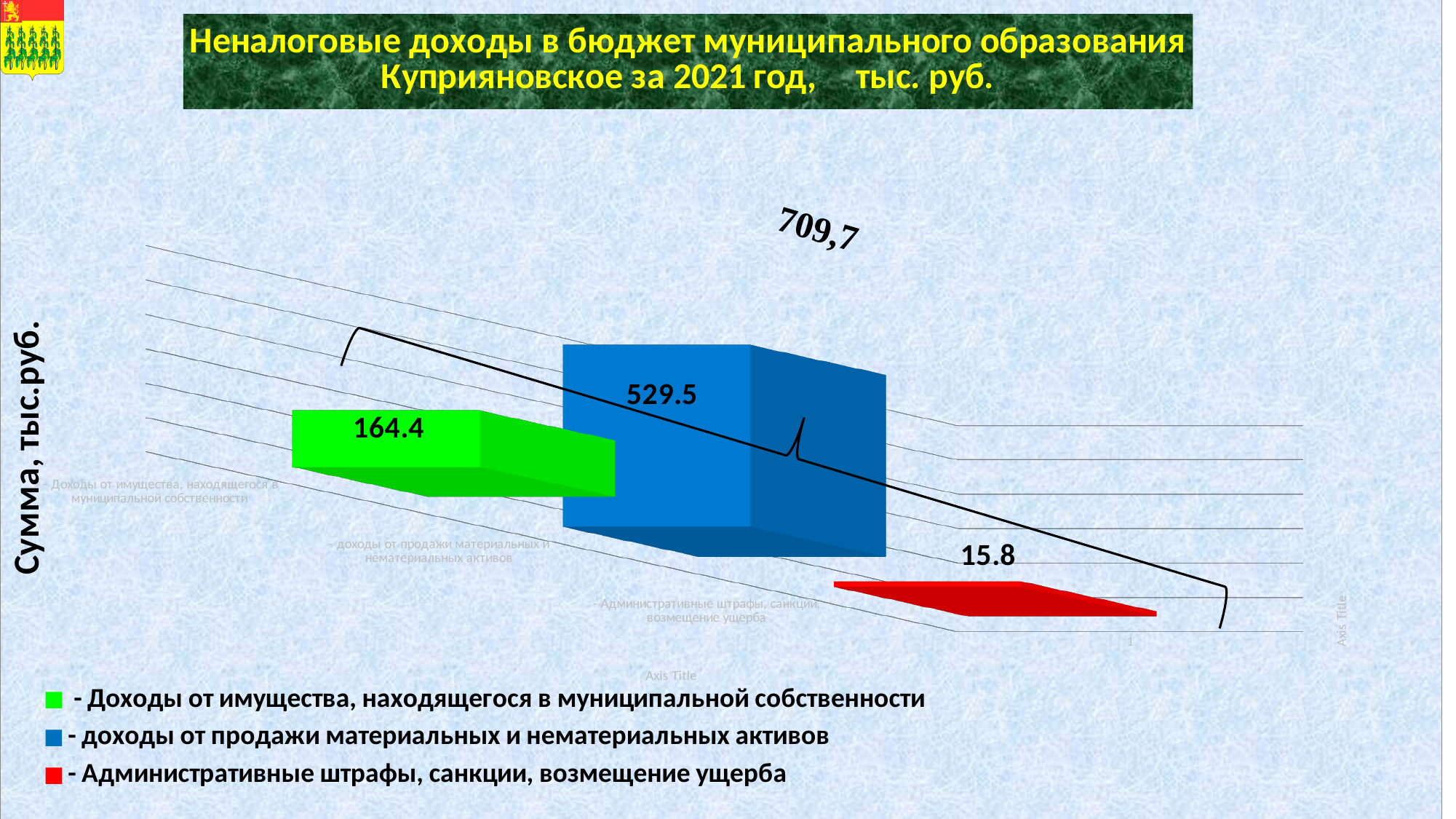
How many bars are plotted on the chart? 3 What is the value for 'доходы от продажи материальных и нематериальных активов'? 529.5 What is the difference between the value for 'доходы от продажи материальных и нематериальных активов' and the value for 'Доходы от имущества, находящегося в муниципальной собственности'? 365.1 Which category has the lowest value? Административные штрафы, санкции, возмещение ущерба What kind of chart is shown on the slide? bar chart What is the value for 'Административные штрафы, санкции, возмещение ущерба'? 15.8 Which is larger: the value for 'Доходы от имущества, находящегося в муниципальной собственности' or the value for 'Административные штрафы, санкции, возмещение ущерба'? Доходы от имущества, находящегося в муниципальной собственности How many entries does the legend list? 3 What total is shown above the bracket spanning all three bars? 709,7 What colour is the bar for 'Административные штрафы, санкции, возмещение ущерба'? red What is the value for 'Доходы от имущества, находящегося в муниципальной собственности'? 164.4 Which category has the highest value? доходы от продажи материальных и нематериальных активов